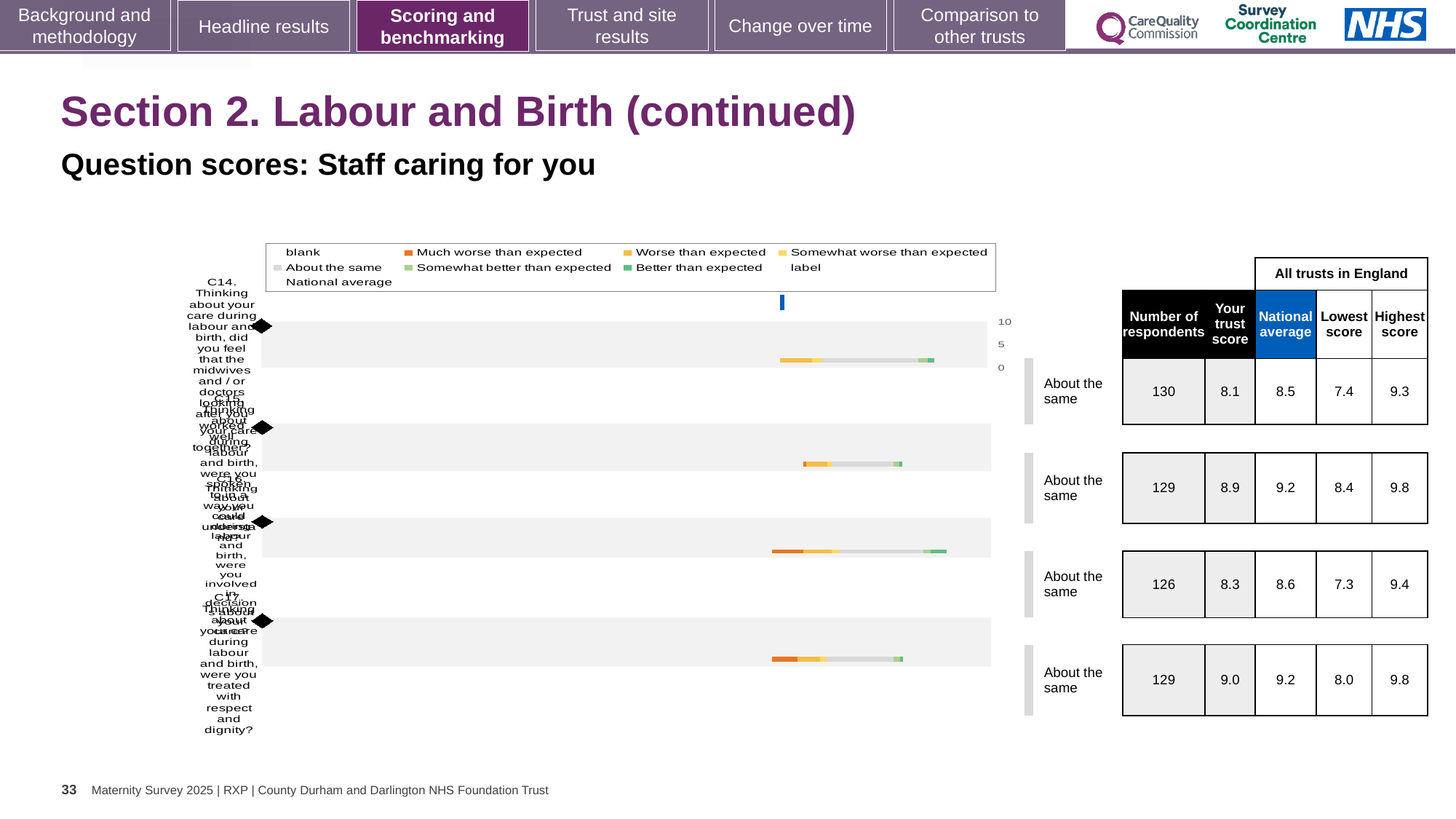
In the table beside the chart, what is 'Your trust score' for the first row (C14)? 8.1 In the table beside the chart, what is the national average for the second row (C15)? 9.2 How many question rows (C14 to C17) are plotted in the chart? 4 How many entries does the chart legend list? 9 Which legend entry is shown in grey? About the same What colour does the legend use for 'Much worse than expected'? orange What kind of chart is shown on the slide? bar chart For the third row (C16), which is larger: the trust score or the national average? National average (8.6) What benchmark category is shown for the fourth row (C17)? About the same For the first row (C14), what is the difference between the highest score (9.3) and the lowest score (7.4) in the table? 1.9 In the table beside the chart, which row has the lowest number of respondents? C16 (third row), 126 In the table beside the chart, which row has the highest 'Your trust score'? C17 (fourth row), 9.0